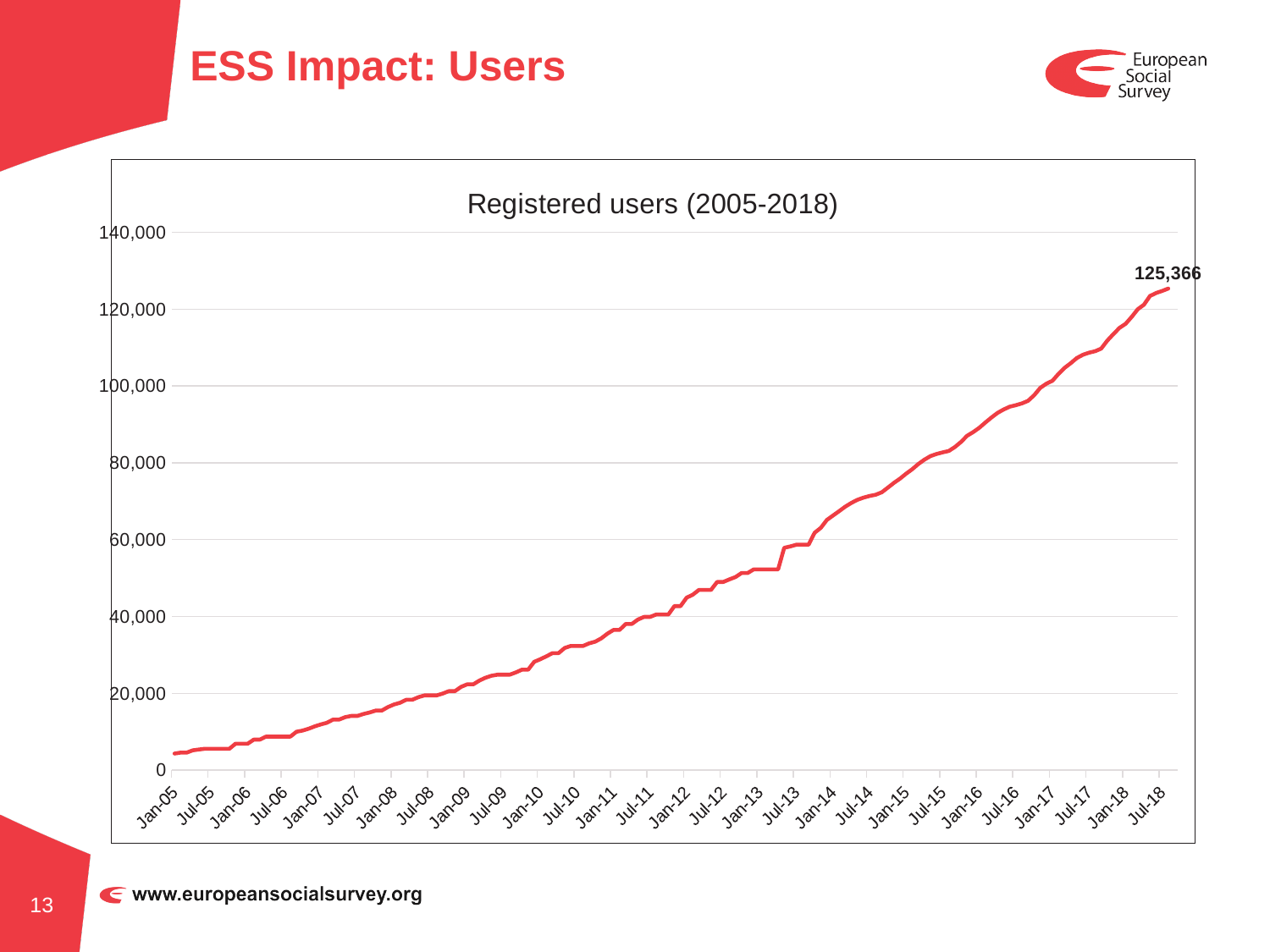
What is the highest value shown on the chart? 125,366 What kind of chart is shown on the slide? line chart Is the value for Jan-10 greater or less than 40,000? less What is the title of the chart? Registered users (2005-2018) Which has more registered users, Jan-12 or Jan-14? Jan-14 Is the value for Jul-17 greater or less than 100,000? greater Is the value for Jan-16 greater or less than 80,000? greater Do the registered users rise or fall over time from Jan-05 to Jul-18? rise What colour is the line on the chart? red What is the value shown by the data label at the end of the line? 125,366